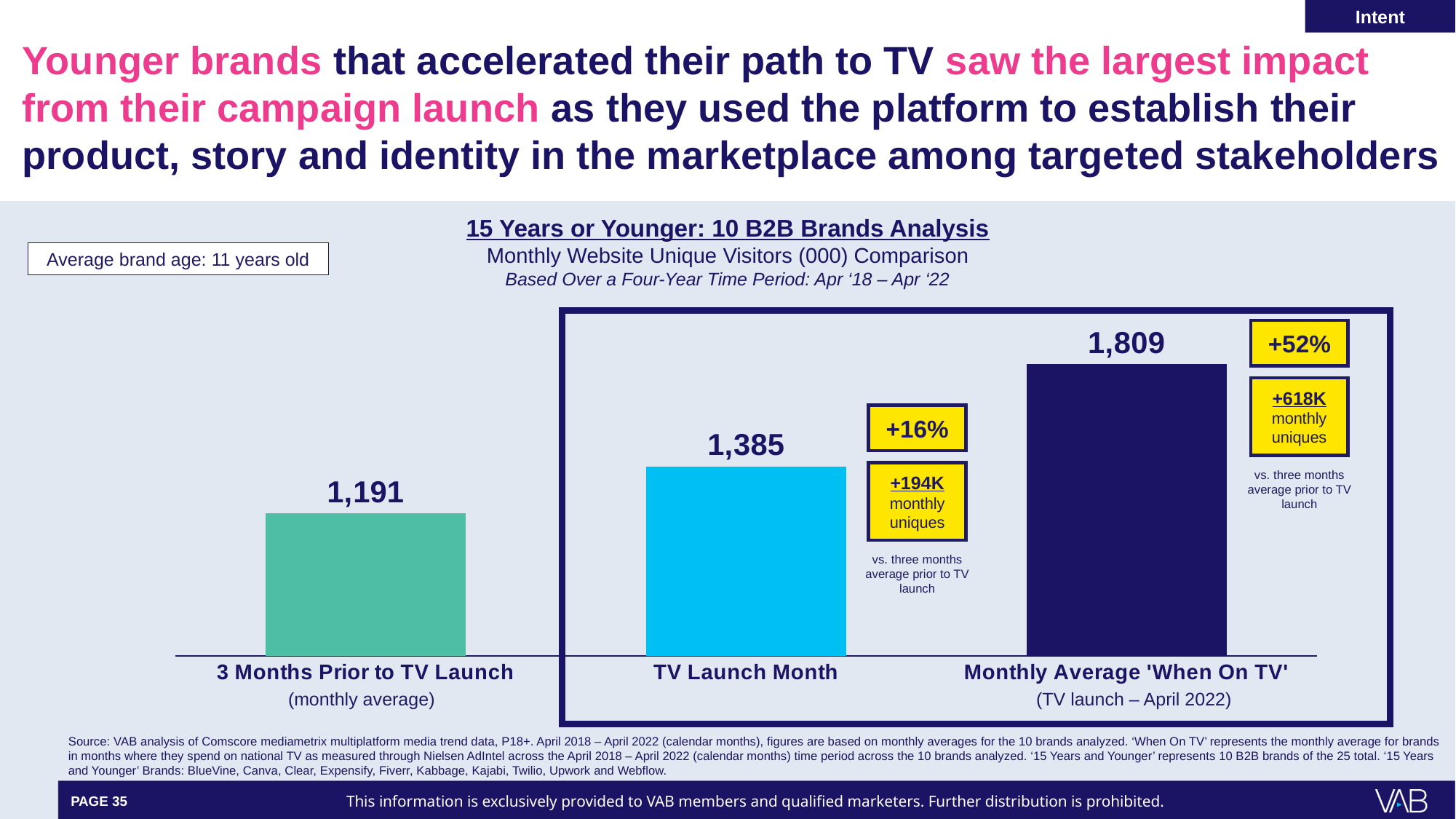
What is the difference between the Monthly Average 'When On TV' value and the '3 Months Prior to TV Launch' value? 618 What is the value for '3 Months Prior to TV Launch'? 1,191 Which is larger, the value for 'TV Launch Month' or the value for '3 Months Prior to TV Launch'? TV Launch Month What kind of chart is shown on the slide? Bar chart What percentage increase is shown in the callout next to the Monthly Average 'When On TV' bar? +52% What is the value for 'TV Launch Month'? 1,385 What is the difference between the 'TV Launch Month' value and the '3 Months Prior to TV Launch' value? 194 How many categories are shown in the chart? 3 Which category has the lowest value? 3 Months Prior to TV Launch Do the values rise or fall from left to right across the categories? Rise What is the value for Monthly Average 'When On TV'? 1,809 Which category has the highest value? Monthly Average 'When On TV'